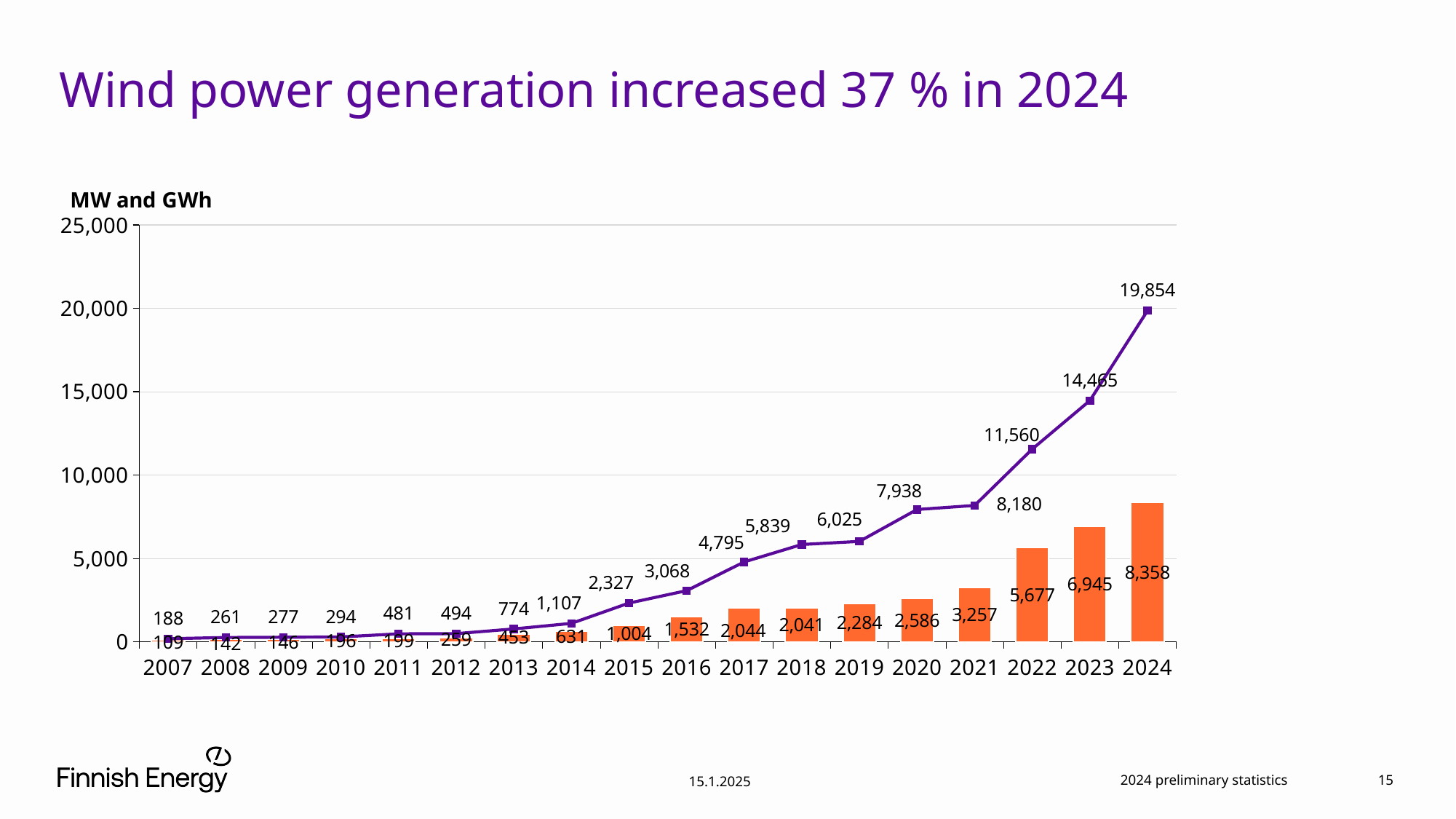
What is the difference between the purple line values for 2024 and 2022? 8,294 In which year does the purple line reach its highest value? 2024 In which year is the purple line at its lowest value? 2007 What is the value of the purple line for 2015? 2,327 What is the value of the purple line for 2024? 19,854 What is the overall trend of the purple line from 2007 to 2024? rising What is the value of the purple line for 2020? 7,938 Is the value of the purple line for 2023 greater or less than 10,000? greater What is the value of the orange bar for 2022? 5,677 How many years are shown on the x axis? 18 What is the value of the orange bar for 2024? 8,358 Which is larger, the orange bar for 2017 or the orange bar for 2018? 2017